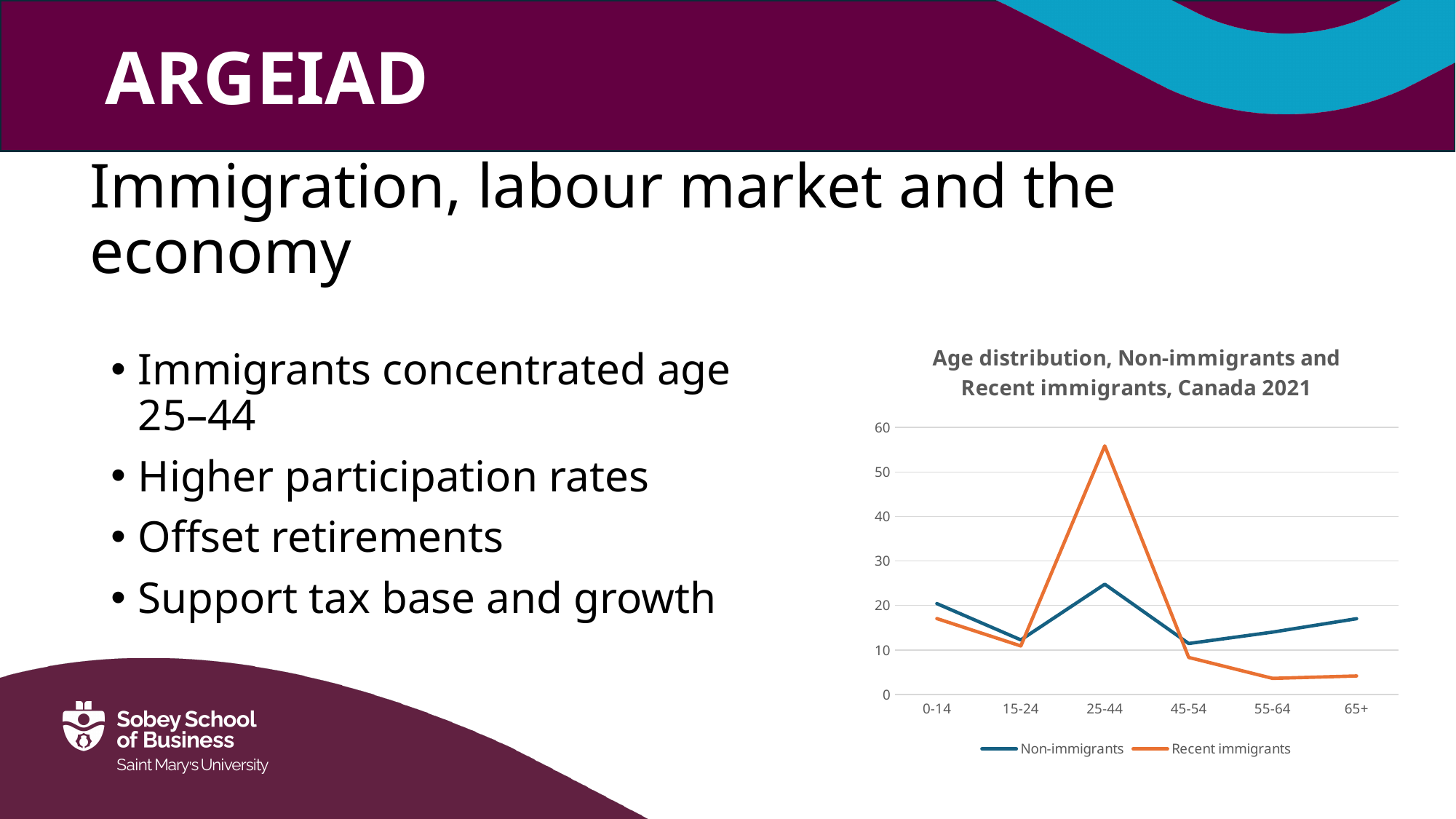
Do the values for Recent immigrants rise or fall from 25-44 to 55-64? fall Is the value for Recent immigrants at 65+ greater or less than 10? less At age group 65+, which series has the larger value, Non-immigrants or Recent immigrants? Non-immigrants What is the title of the chart? Age distribution, Non-immigrants and Recent immigrants, Canada 2021 How many age groups are shown on the x axis? 6 Which age group has the lowest value for Recent immigrants? 55-64 Is the value for Non-immigrants at 25-44 greater or less than 30? less Is the value for Recent immigrants at 25-44 greater or less than 50? greater How many series does the legend list? 2 Which age group has the highest value for Recent immigrants? 25-44 Which age group has the highest value for Non-immigrants? 25-44 What kind of chart is shown on the slide? line chart